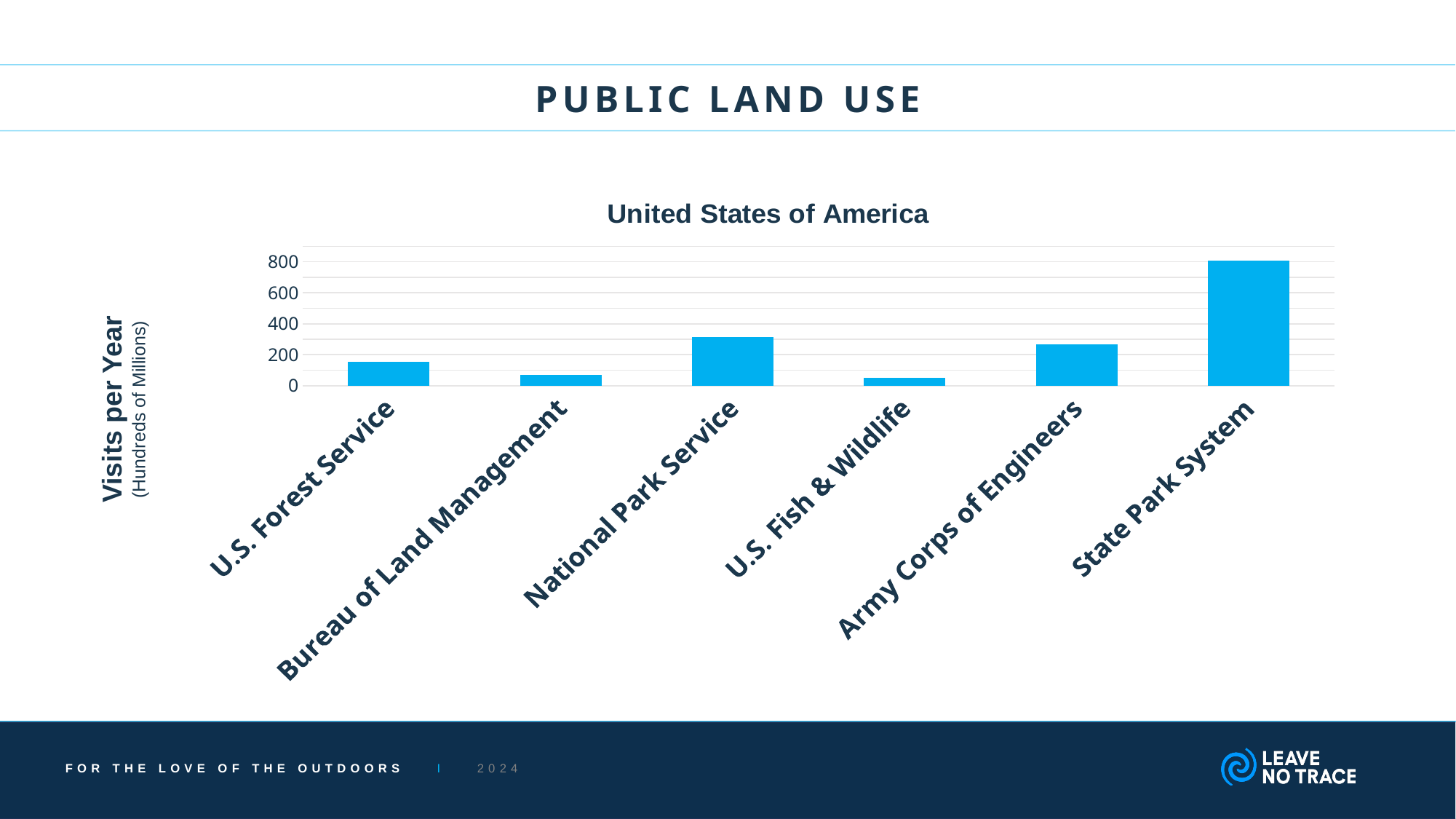
What is the title of the chart? United States of America How many categories are plotted in the chart? 6 Is the value for U.S. Forest Service greater or less than 200? less Which category has the highest value in the chart? State Park System Which is larger, the value for National Park Service or the value for U.S. Forest Service? National Park Service What kind of chart is shown on the slide? bar chart What is the label on the vertical axis of the chart? Visits per Year (Hundreds of Millions) Is the value for U.S. Fish & Wildlife greater or less than 200? less Is the value for Bureau of Land Management greater or less than 200? less